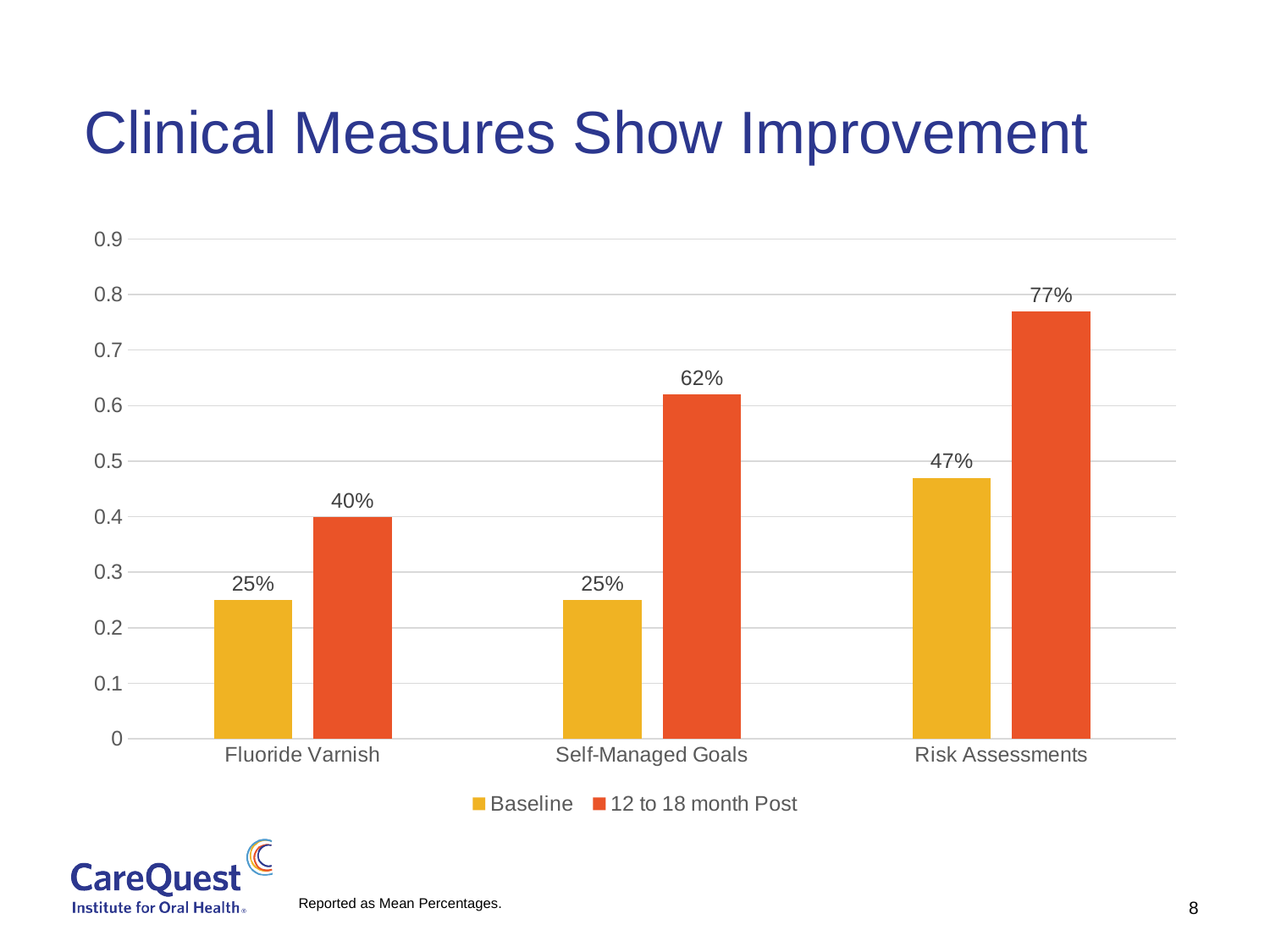
What is the Baseline value for Risk Assessments? 47% What kind of chart is shown on the slide? Bar chart What is the Baseline value for Fluoride Varnish? 25% Which category has the lowest 12 to 18 month Post value? Fluoride Varnish What is the title of the slide? Clinical Measures Show Improvement Which is larger for Fluoride Varnish: the Baseline value or the 12 to 18 month Post value? 12 to 18 month Post How many categories are shown on the x axis? 3 What is the 12 to 18 month Post value for Risk Assessments? 77% What is the 12 to 18 month Post value for Self-Managed Goals? 62% Which category has the highest 12 to 18 month Post value? Risk Assessments What is the difference between the 12 to 18 month Post and Baseline values for Self-Managed Goals? 37% How many series does the legend list? 2